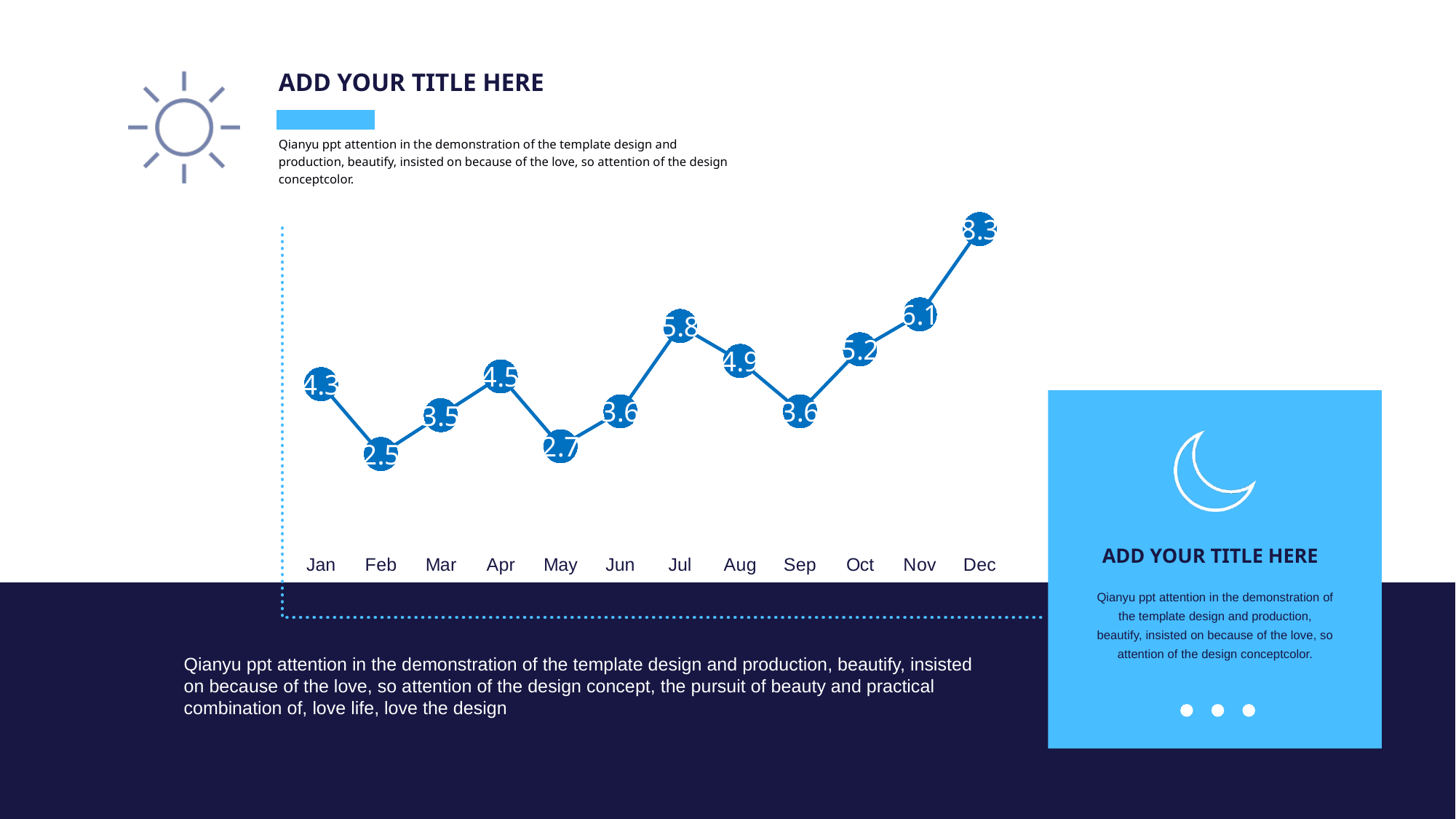
What is the difference between the values for Jul and Jun? 2.2 Do the values rise or fall from Sep to Dec? Rise What is the value for Feb? 2.5 Which month has the lowest value? Feb What is the value for Apr? 4.5 What kind of chart is shown on the slide? Line chart What is the difference between the values for Nov and Oct? 0.9 Which month has the highest value? Dec What is the value for Jul? 5.8 What is the value for Nov? 6.1 Which is larger, the value for Aug or the value for Sep? Aug How many months are plotted on the x axis? 12